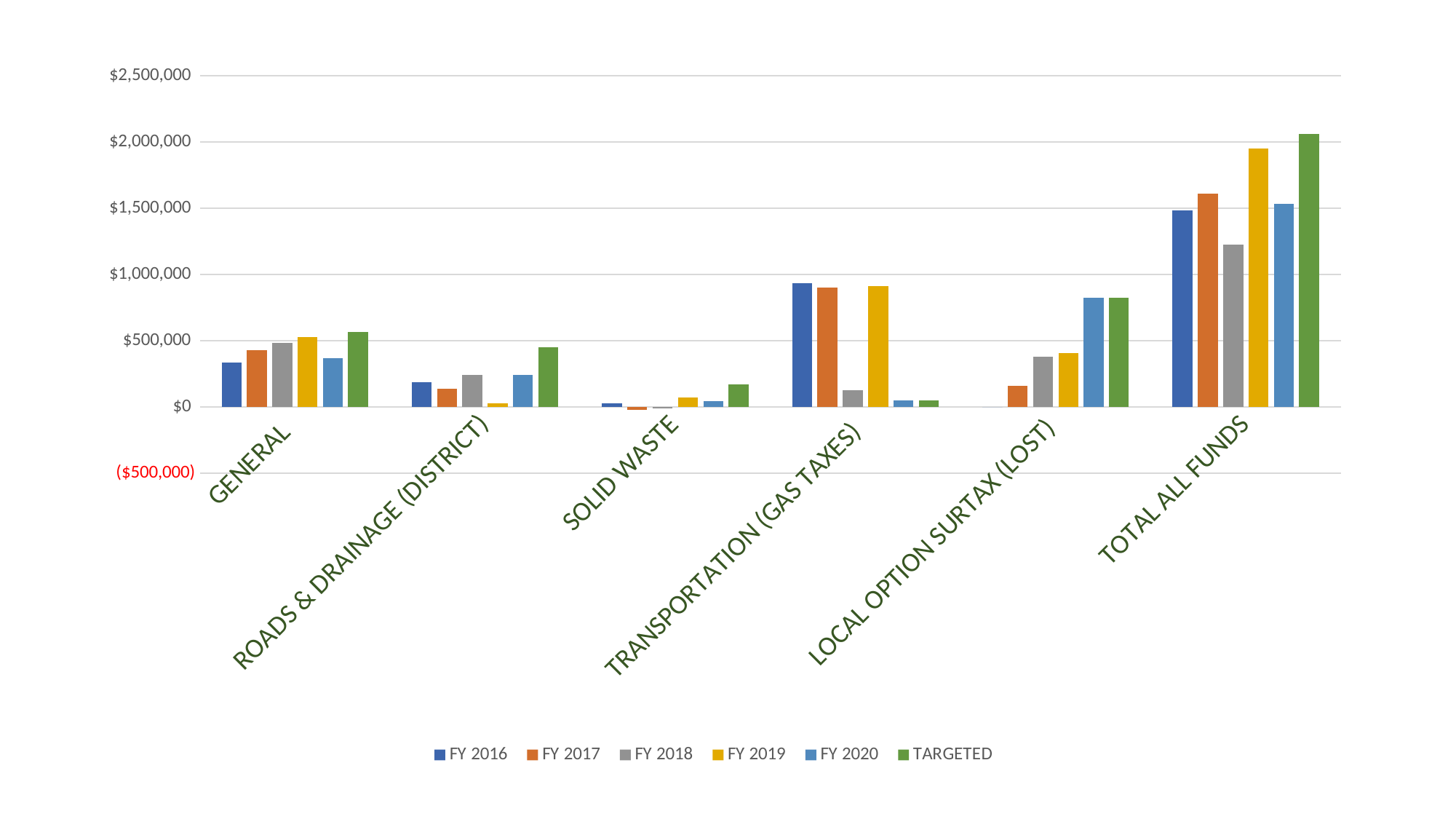
Within TOTAL ALL FUNDS, which series has the lowest value? FY 2018 How many series does the legend list? 6 Is the TARGETED value for GENERAL greater or less than $500,000? greater Is the FY 2016 value for TRANSPORTATION (GAS TAXES) greater or less than $500,000? greater What kind of chart is shown on the slide? Bar chart Which category has the highest TARGETED value? TOTAL ALL FUNDS For TRANSPORTATION (GAS TAXES), which is larger, the FY 2016 value or the FY 2018 value? FY 2016 Is the FY 2019 value for TOTAL ALL FUNDS greater or less than $1,500,000? greater How many categories are shown on the x axis? 6 What is the lowest tick label shown on the vertical axis? ($500,000) For LOCAL OPTION SURTAX (LOST), which is larger, the FY 2017 value or the FY 2020 value? FY 2020